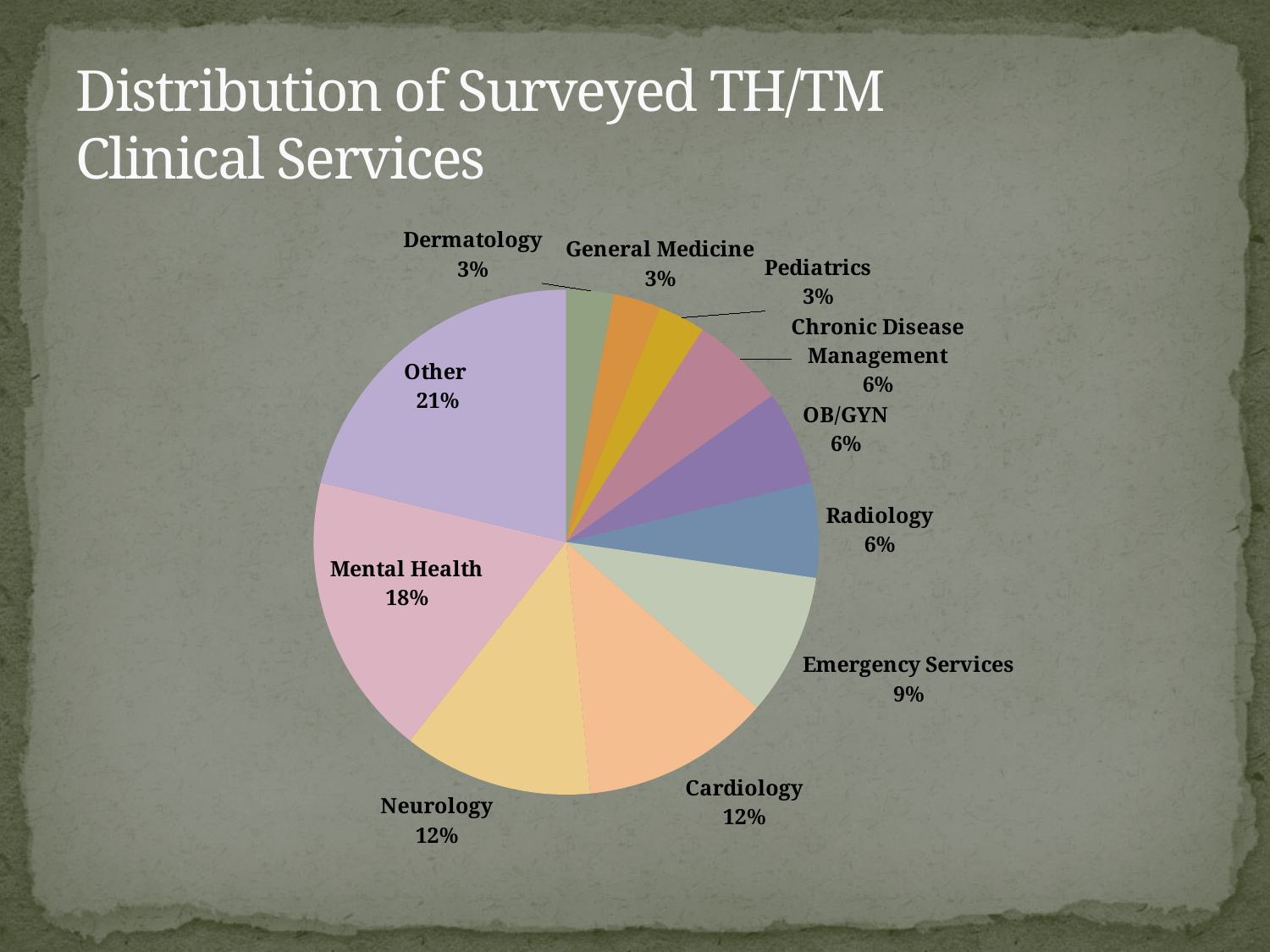
What is the value shown for Emergency Services? 9% Which category has the largest slice of the pie? Other What share of the pie does Mental Health represent? 18% What is the value shown for Radiology? 6% What is the title of the slide containing the chart? Distribution of Surveyed TH/TM Clinical Services What kind of chart is shown on the slide? Pie chart What is the difference between the Other slice and the Mental Health slice? 3% Which is larger, Neurology or Mental Health? Mental Health What is the value shown for Chronic Disease Management? 6% What is the difference between Cardiology and Dermatology? 9% Which is larger, Emergency Services or Radiology? Emergency Services How many categories are shown in the pie chart? 11